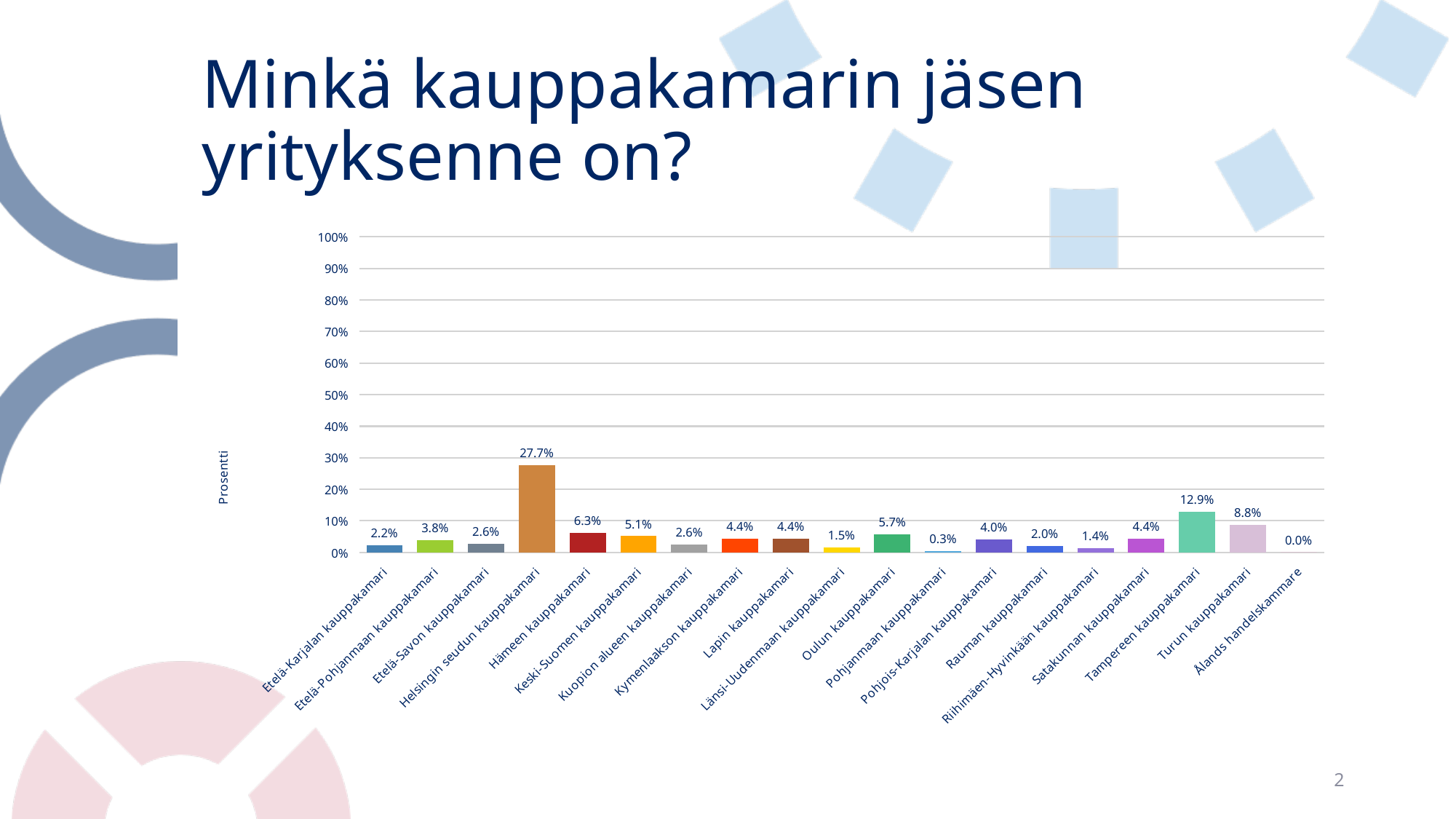
Which is larger, the value for Hämeen kauppakamari or the value for Oulun kauppakamari? Hämeen kauppakamari What is the value for Turun kauppakamari? 8.8% What is the label of the y axis? Prosentti What is the value for Pohjanmaan kauppakamari? 0.3% What is the difference between the values for Helsingin seudun kauppakamari and Tampereen kauppakamari? 14.8% How many categories are shown on the x axis? 19 What kind of chart is shown on the slide? bar chart Which category has the lowest value? Ålands handelskammare What is the value for Tampereen kauppakamari? 12.9% Is the value for Helsingin seudun kauppakamari greater or less than 20%? greater Which category has the highest value? Helsingin seudun kauppakamari What is the value for Helsingin seudun kauppakamari? 27.7%